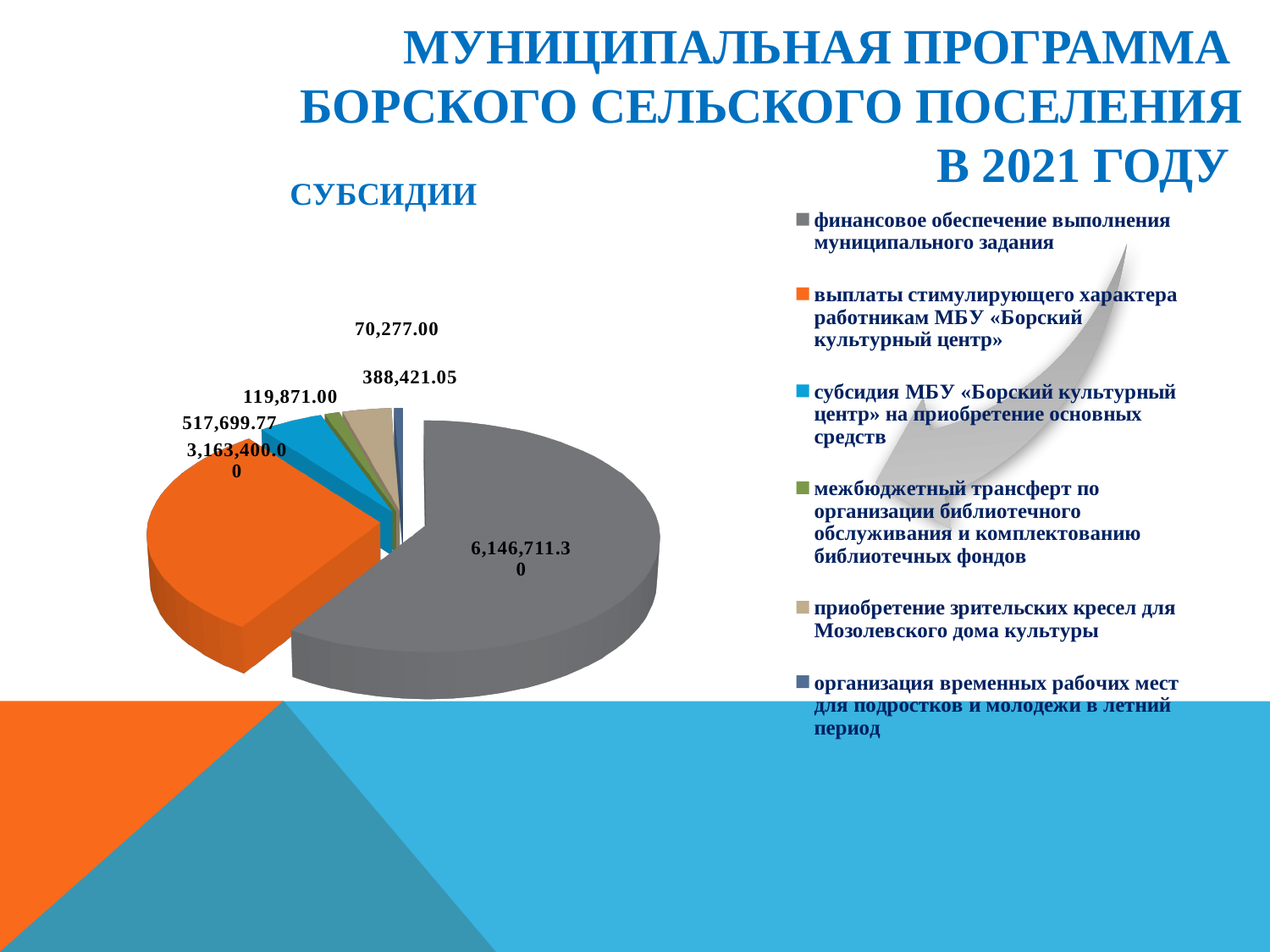
What kind of chart is shown on the slide? Pie chart Which category has the smallest slice of the pie? организация временных рабочих мест для подростков и молодежи в летний период What is the value for «субсидия МБУ «Борский культурный центр» на приобретение основных средств»? 517,699.77 How many slices does the pie chart have? 6 What is the title of the chart? СУБСИДИИ What is the value for «организация временных рабочих мест для подростков и молодежи в летний период»? 70,277.00 What is the difference between «финансовое обеспечение выполнения муниципального задания» and «выплаты стимулирующего характера работникам МБУ «Борский культурный центр»»? 2,983,311.30 What is the value for «приобретение зрительских кресел для Мозолевского дома культуры»? 388,421.05 Which category has the largest slice of the pie? финансовое обеспечение выполнения муниципального задания What is the value for «финансовое обеспечение выполнения муниципального задания»? 6,146,711.30 What is the value for «выплаты стимулирующего характера работникам МБУ «Борский культурный центр»»? 3,163,400.00 Which is larger: «межбюджетный трансферт по организации библиотечного обслуживания и комплектованию библиотечных фондов» or «приобретение зрительских кресел для Мозолевского дома культуры»? приобретение зрительских кресел для Мозолевского дома культуры